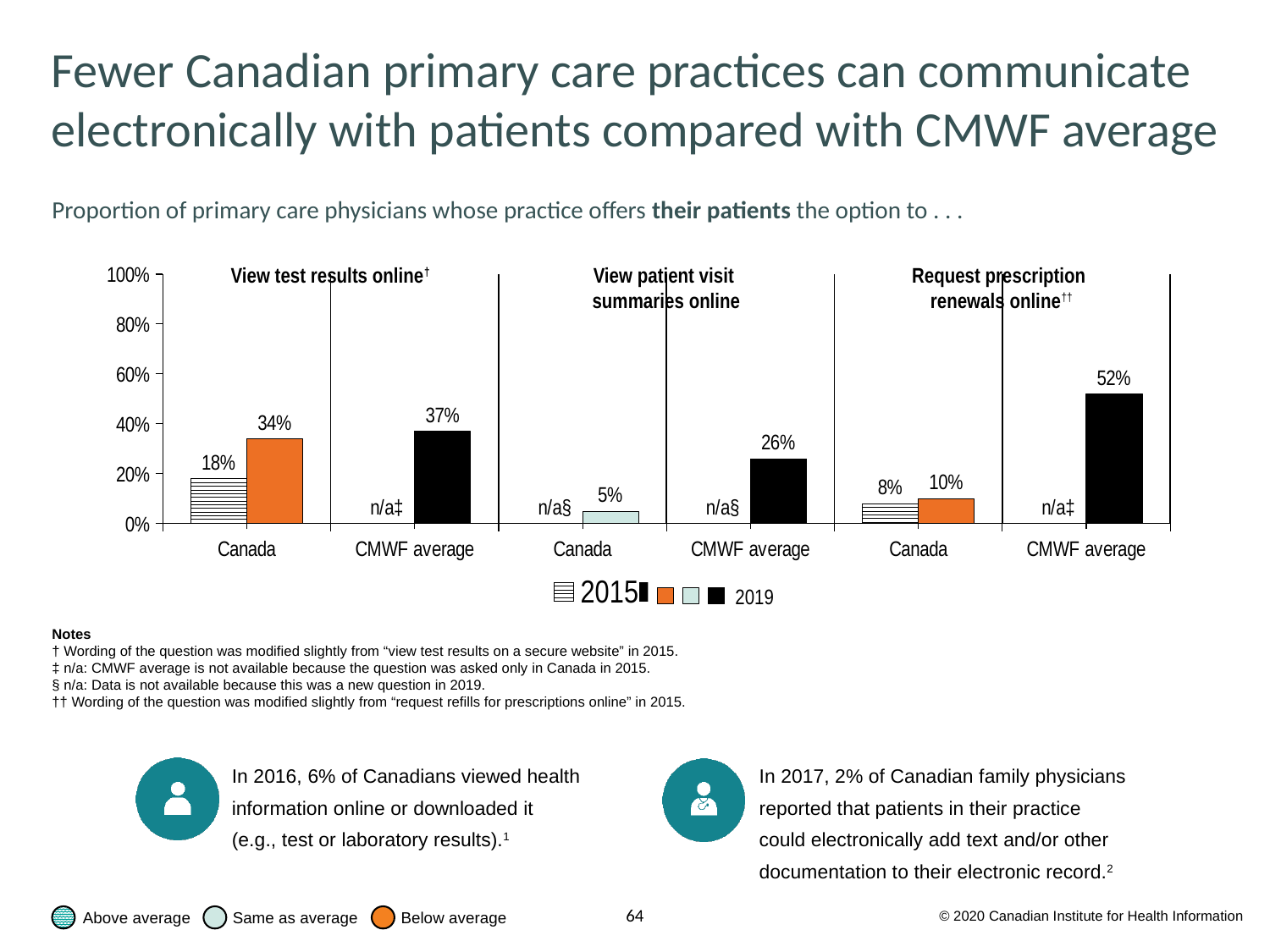
What was the 2019 value for Canada for the option to view test results online? 34% Which is larger for viewing test results online in 2019: Canada or the CMWF average? CMWF average What is the difference between the 2019 CMWF average and the 2019 Canada value for requesting prescription renewals online? 42 percentage points What was the 2015 value for Canada for the option to request prescription renewals online? 8% What was the 2019 value for Canada for the option to view patient visit summaries online? 5% What was the 2019 CMWF average for the option to request prescription renewals online? 52% What was the 2019 CMWF average for the option to view patient visit summaries online? 26% How many series does the chart legend list? 2 What type of chart is shown on the slide? Bar chart By how many percentage points did Canada's value for viewing test results online increase from 2015 to 2019? 16 percentage points What was the 2015 value for Canada for the option to view test results online? 18% Which option has the highest 2019 CMWF average? Request prescription renewals online